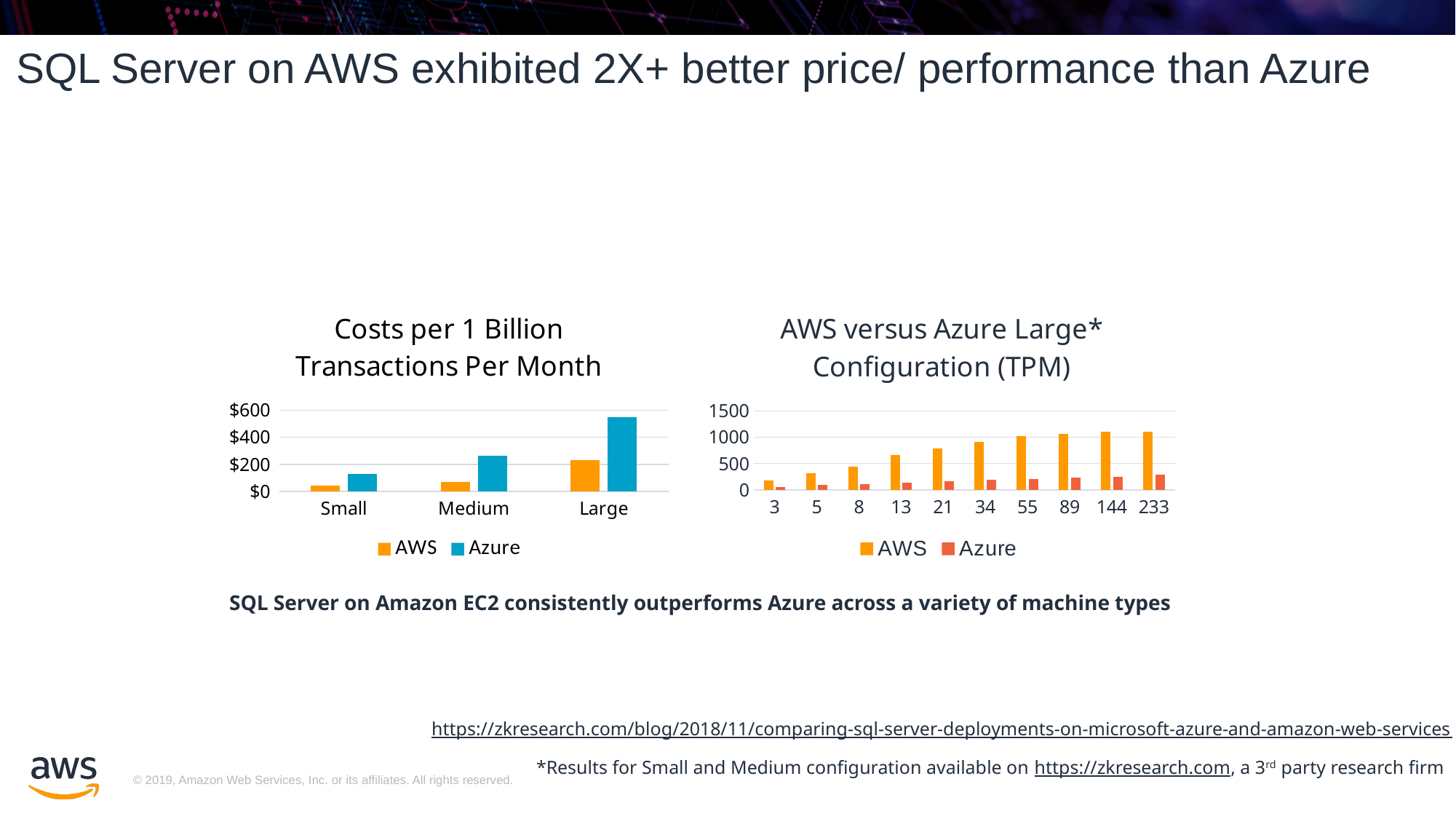
In the "Costs per 1 Billion Transactions Per Month" chart, do the Azure costs rise or fall from Small to Large? rise In the "AWS versus Azure Large* Configuration (TPM)" chart, do the AWS values rise or fall along the x axis from 3 to 233? rise What type of chart is the "Costs per 1 Billion Transactions Per Month" chart? bar chart How many series does the legend of the "Costs per 1 Billion Transactions Per Month" chart list? 2 In the "Costs per 1 Billion Transactions Per Month" chart, is the Azure value for Large greater or less than $400? greater How many categories are shown on the x axis of the "AWS versus Azure Large* Configuration (TPM)" chart? 10 In the "AWS versus Azure Large* Configuration (TPM)" chart, is the AWS value at 233 greater or less than 1000? greater In the "Costs per 1 Billion Transactions Per Month" chart, is the AWS value for Large greater or less than $400? less In the "Costs per 1 Billion Transactions Per Month" chart, which is larger for Medium, the AWS cost or the Azure cost? Azure In the "Costs per 1 Billion Transactions Per Month" chart, which category has the highest Azure cost? Large How many categories are shown on the x axis of the "Costs per 1 Billion Transactions Per Month" chart? 3